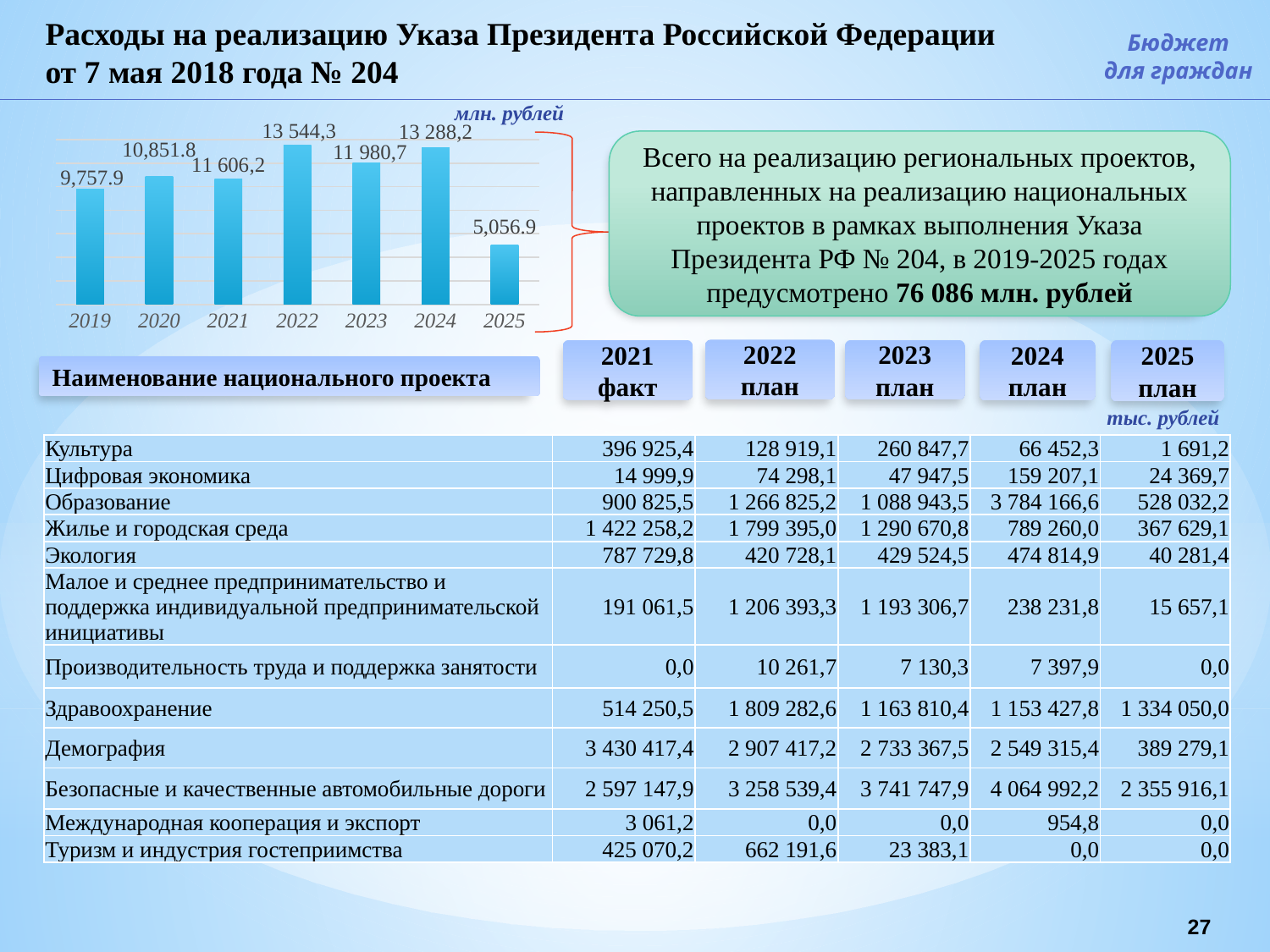
What is the value shown for 2025 in the bar chart? 5,056.9 What is the value shown for 2022 in the bar chart? 13 544,3 What is the value shown for 2023 in the bar chart? 11 980,7 What type of chart is shown on the slide? bar chart Do the values in the bar chart rise or fall from 2019 to 2022? rise What is the value shown for 2019 in the bar chart? 9,757.9 Which year has the highest value in the bar chart? 2022 How many years are plotted in the bar chart? 7 What is the difference between the values for 2022 and 2024 in the bar chart? 256,1 Which year has the lowest value in the bar chart? 2025 Which year has the larger value in the bar chart, 2023 or 2024? 2024 What unit is indicated above the bar chart? млн. рублей